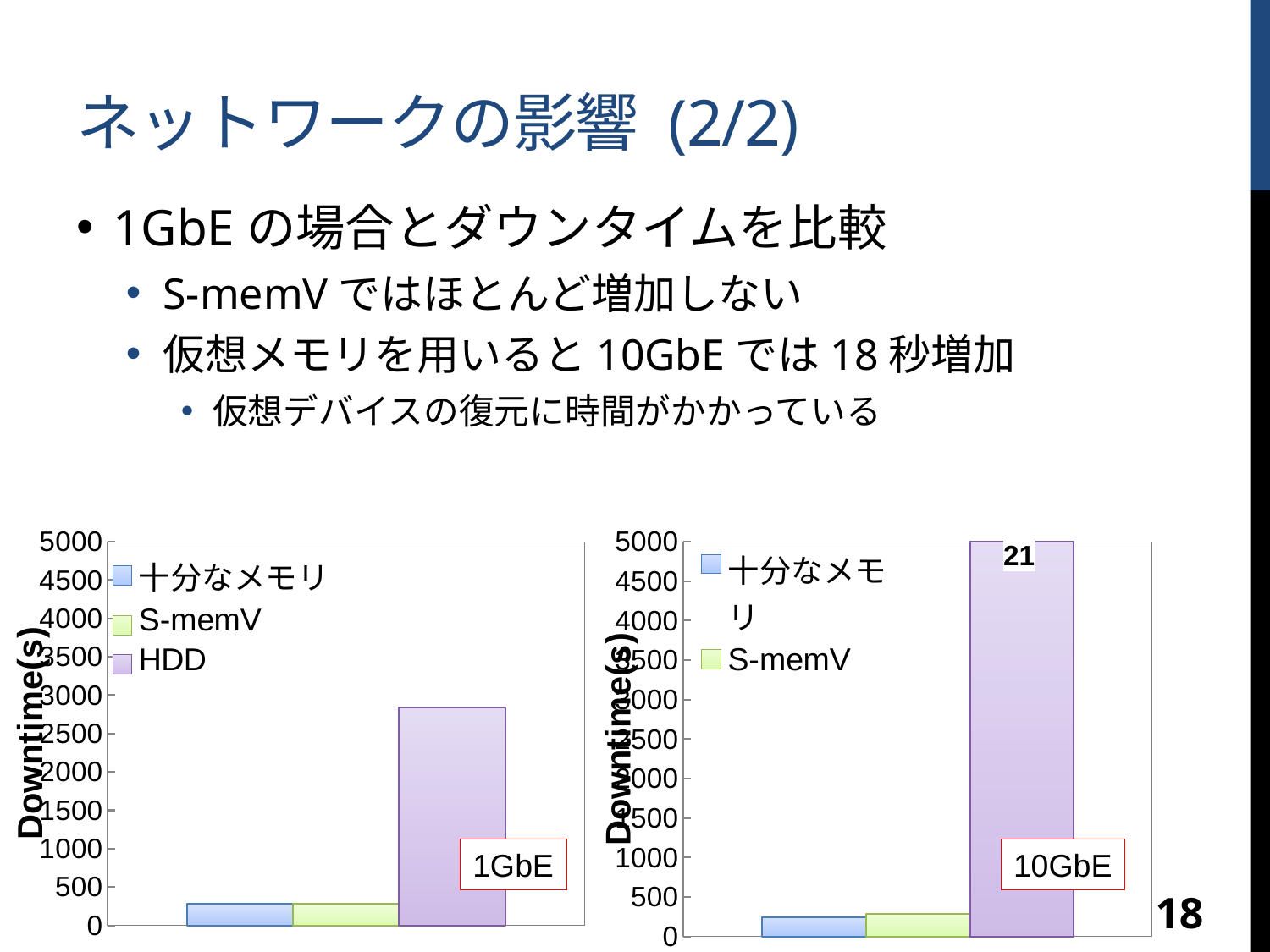
What network label is shown inside the right chart? 10GbE What is the y-axis title of the left chart? Downtime(s) In the left chart (1GbE), which is larger, the value for HDD or the value for S-memV? HDD In the left chart (1GbE), which series has the highest downtime? HDD In the right chart (10GbE), is the value for 十分なメモリ greater or less than 500? less In the left chart (1GbE), is the value for HDD greater or less than 2500? greater What type of chart is the left chart labelled 1GbE? bar chart How many series does the legend of the right chart (10GbE) list? 2 In the right chart (10GbE), is the tallest purple bar greater or less than 4500? greater How many series does the legend of the left chart (1GbE) list? 3